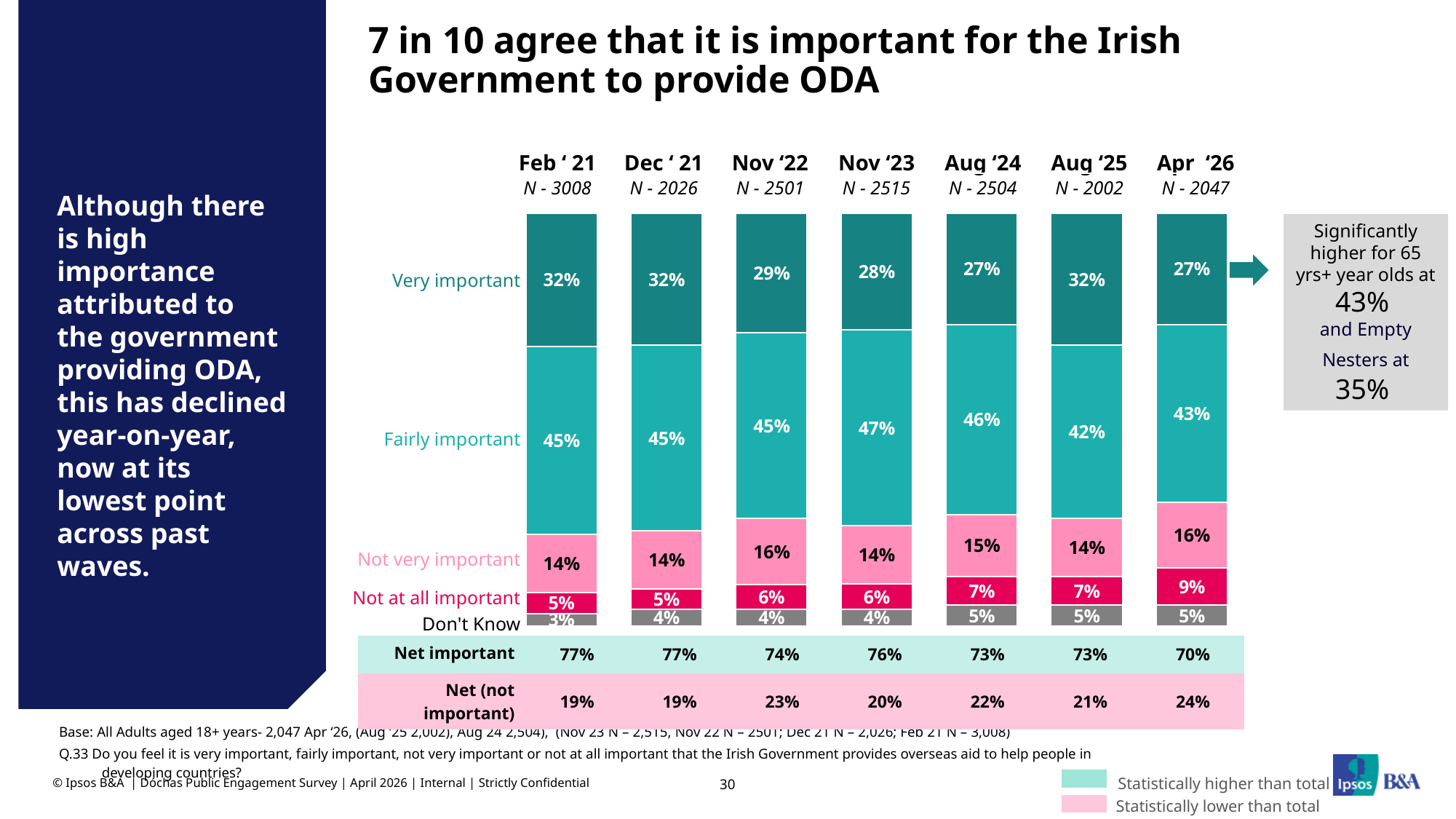
What percentage said 'Very important' in Apr '26? 27% What percentage said 'Not at all important' in Aug '25? 7% What is the difference between the 'Net important' figures for Feb '21 and Apr '26? 7 percentage points What type of chart is used on this slide? Stacked bar chart Which is larger: the 'Fairly important' share in Aug '25 or in Nov '22? Nov '22 How many response categories are stacked in each bar? 5 What percentage said 'Fairly important' in Nov '23? 47% What is the 'Net important' figure for Feb '21? 77% What is the combined share of 'Very important' and 'Fairly important' in Apr '26? 70% In which wave is the 'Not at all important' share highest? Apr '26 In which wave is the 'Net important' figure lowest? Apr '26 How many survey waves are shown in the chart? 7